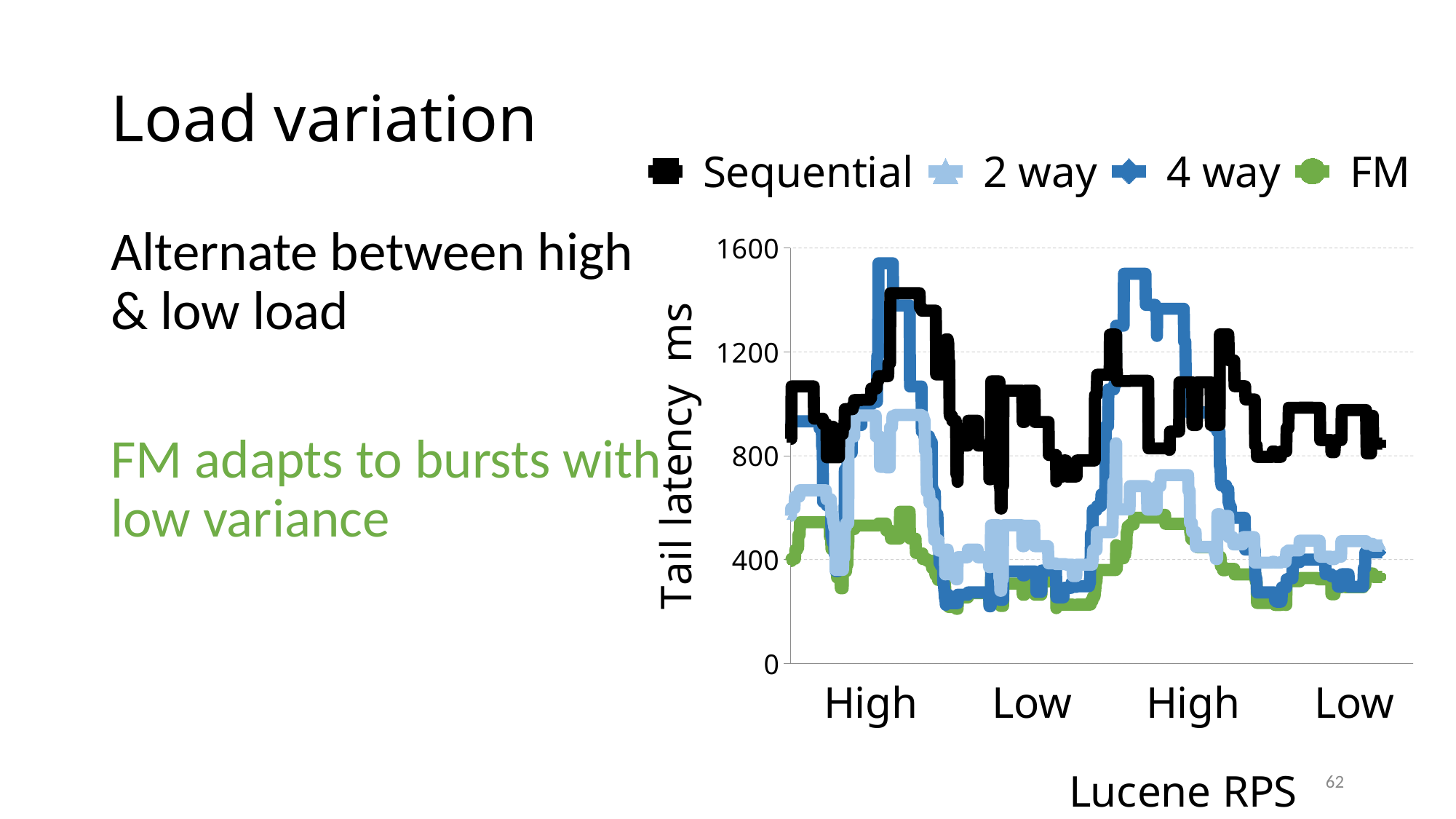
Which series has the lowest peak tail latency? FM Is the lowest value of the Sequential series greater or less than 400? greater What is the x-axis title of the chart? Lucene RPS What is the y-axis title of the chart? Tail latency ms Which series reaches the highest peak tail latency? 4 way Is the peak value of the FM series greater or less than 800? less Is the peak value of the Sequential series greater or less than 1200? greater How many series does the legend list? 4 Which series has the higher peak, Sequential or 2 way? Sequential What kind of chart is shown on the slide? line chart How many load-level labels are shown along the x axis? 4